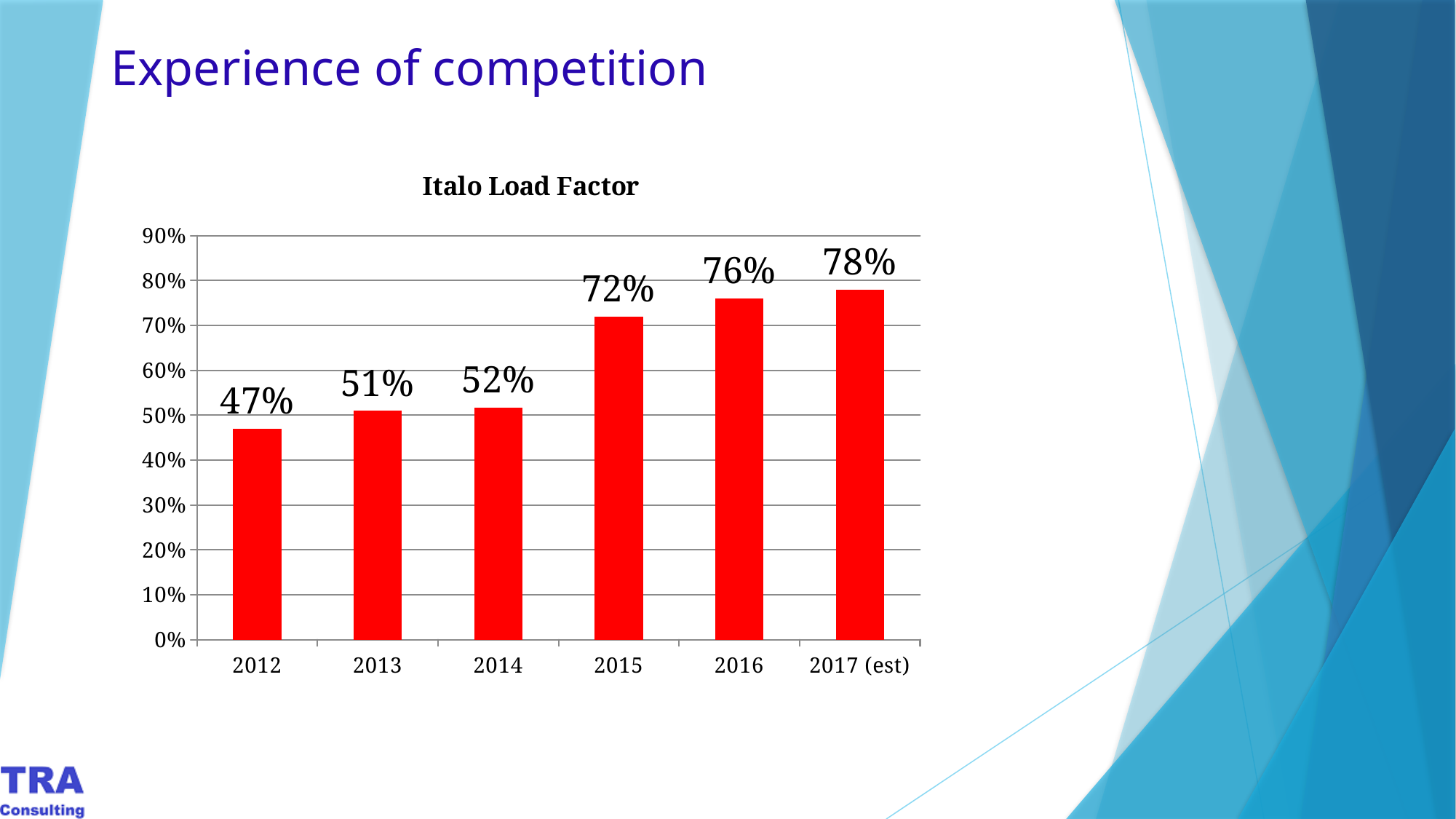
What is the Italo load factor for 2015? 72% What is the Italo load factor for 2012? 47% Which year has the lowest Italo load factor? 2012 What is the Italo load factor for 2017 (est)? 78% Which year has the highest Italo load factor? 2017 (est) How many years are shown on the x axis of the chart? 6 Is the load factor for 2014 greater or less than 60%? less Which year has a higher load factor, 2013 or 2016? 2016 What kind of chart is used to show the Italo load factor? bar chart What is the difference between the load factor in 2015 and in 2014? 20% Does the Italo load factor rise or fall from 2012 to 2017 (est)? rise What is the difference between the load factor in 2017 (est) and in 2012? 31%